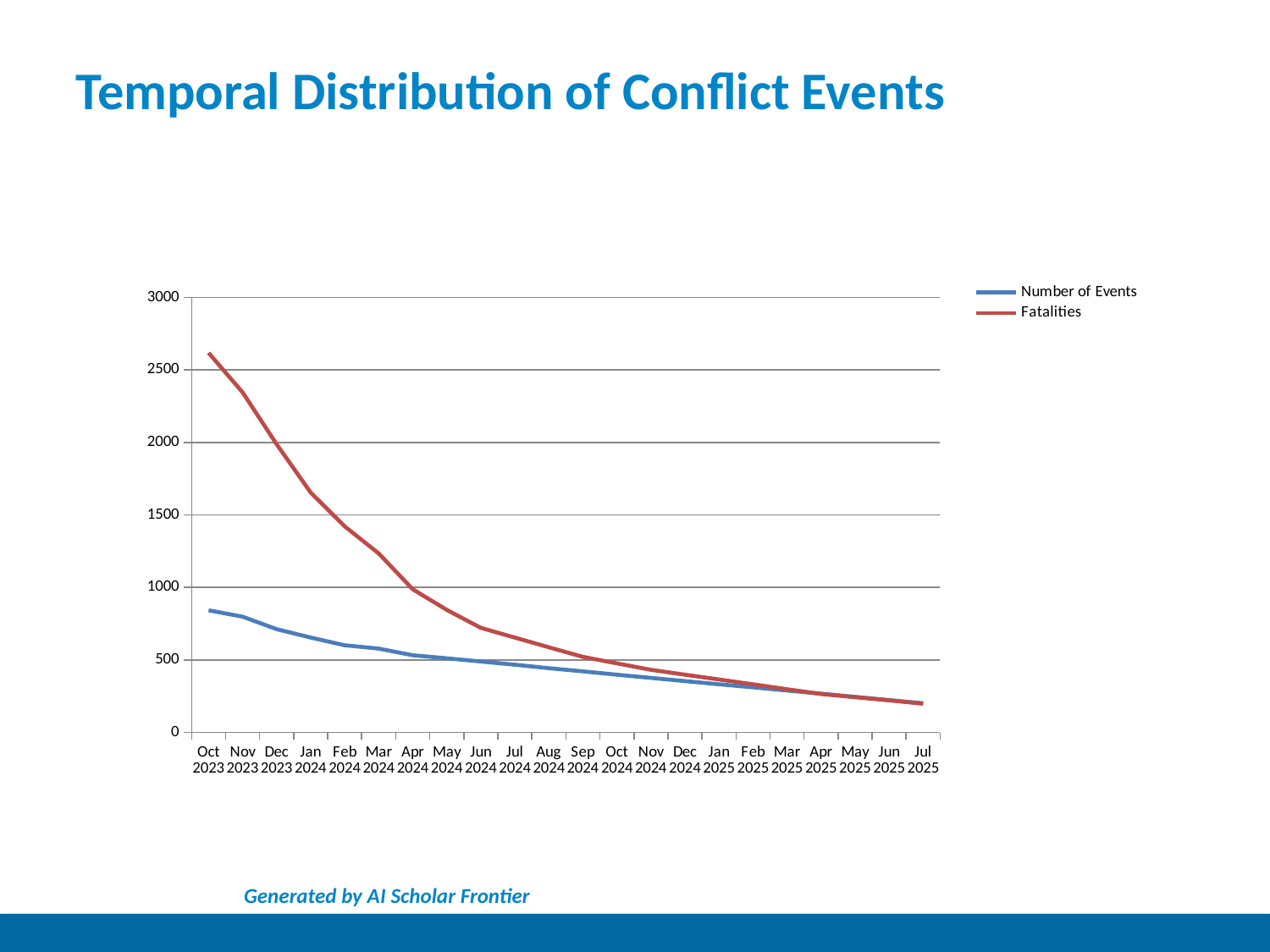
How many series does the legend list? 2 In Oct 2023, which series has the larger value, Fatalities or Number of Events? Fatalities How many time points are plotted along the x axis? 22 In which month is the Number of Events value highest? Oct 2023 Is the Fatalities value for Oct 2023 greater or less than 2500? greater Is the Fatalities value for Jan 2024 greater or less than 1500? greater Do the Fatalities values rise or fall from Oct 2023 to Jul 2025? fall Is the Number of Events value for Jul 2025 greater or less than 500? less Do the Number of Events values rise or fall along the x axis? fall In which month is the Fatalities value highest? Oct 2023 What kind of chart is shown on the slide? line chart